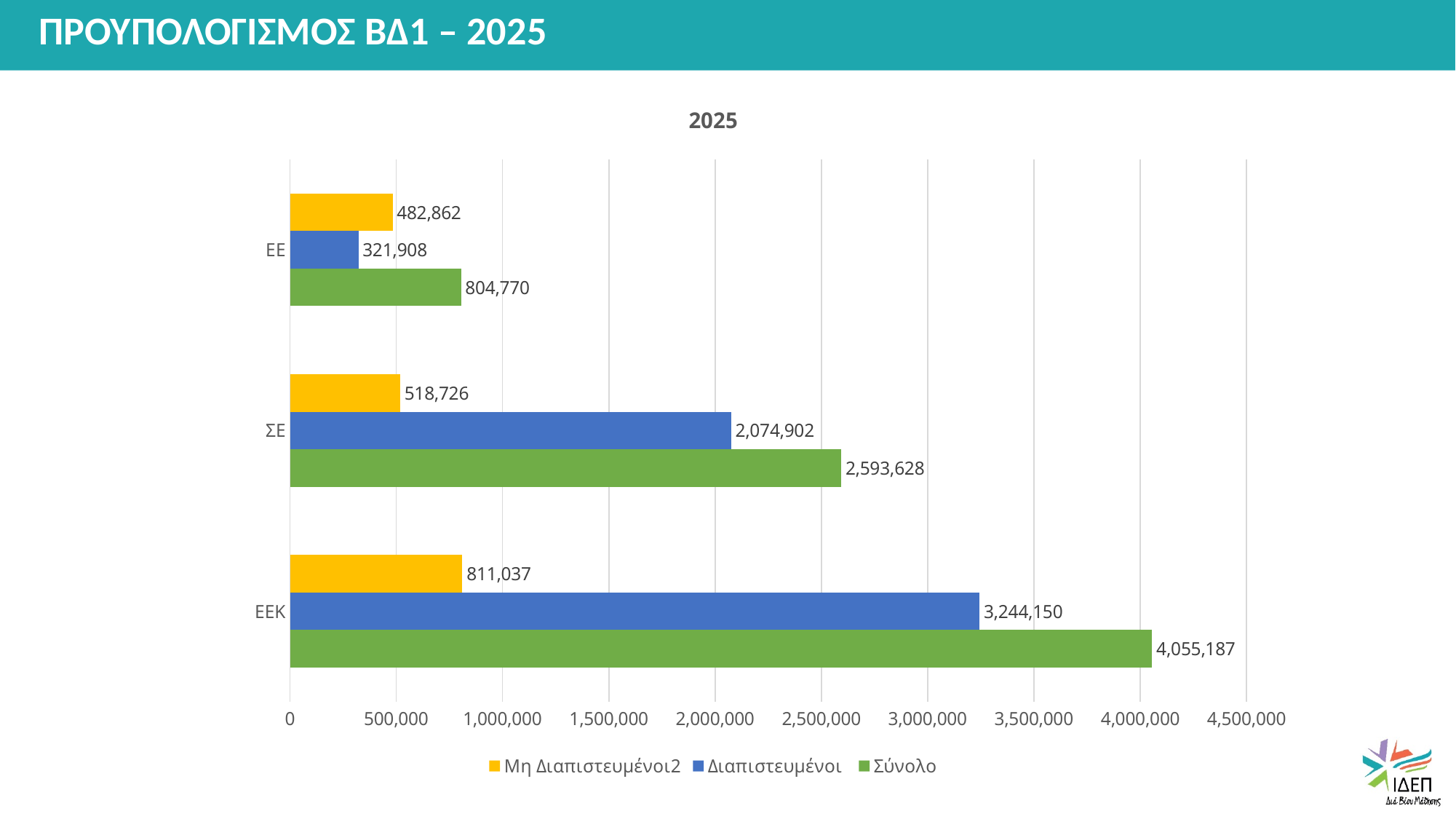
How many categories are shown on the y axis? 3 How many series does the legend list? 3 What is the Διαπιστευμένοι value for ΣΕ? 2,074,902 What is the title of the chart? 2025 What is the Σύνολο value for ΕΕΚ? 4,055,187 Which category has the highest Σύνολο value? ΕΕΚ Is the Διαπιστευμένοι value for ΕΕΚ greater or less than 3,000,000? greater What type of chart is shown on the slide? bar chart What is the Μη Διαπιστευμένοι2 value for ΕΕ? 482,862 What is the difference between the Σύνολο values for ΕΕΚ and ΣΕ? 1,461,559 Which category has the lowest Διαπιστευμένοι value? ΕΕ Which is larger for ΕΕ: the Μη Διαπιστευμένοι2 value or the Διαπιστευμένοι value? Μη Διαπιστευμένοι2